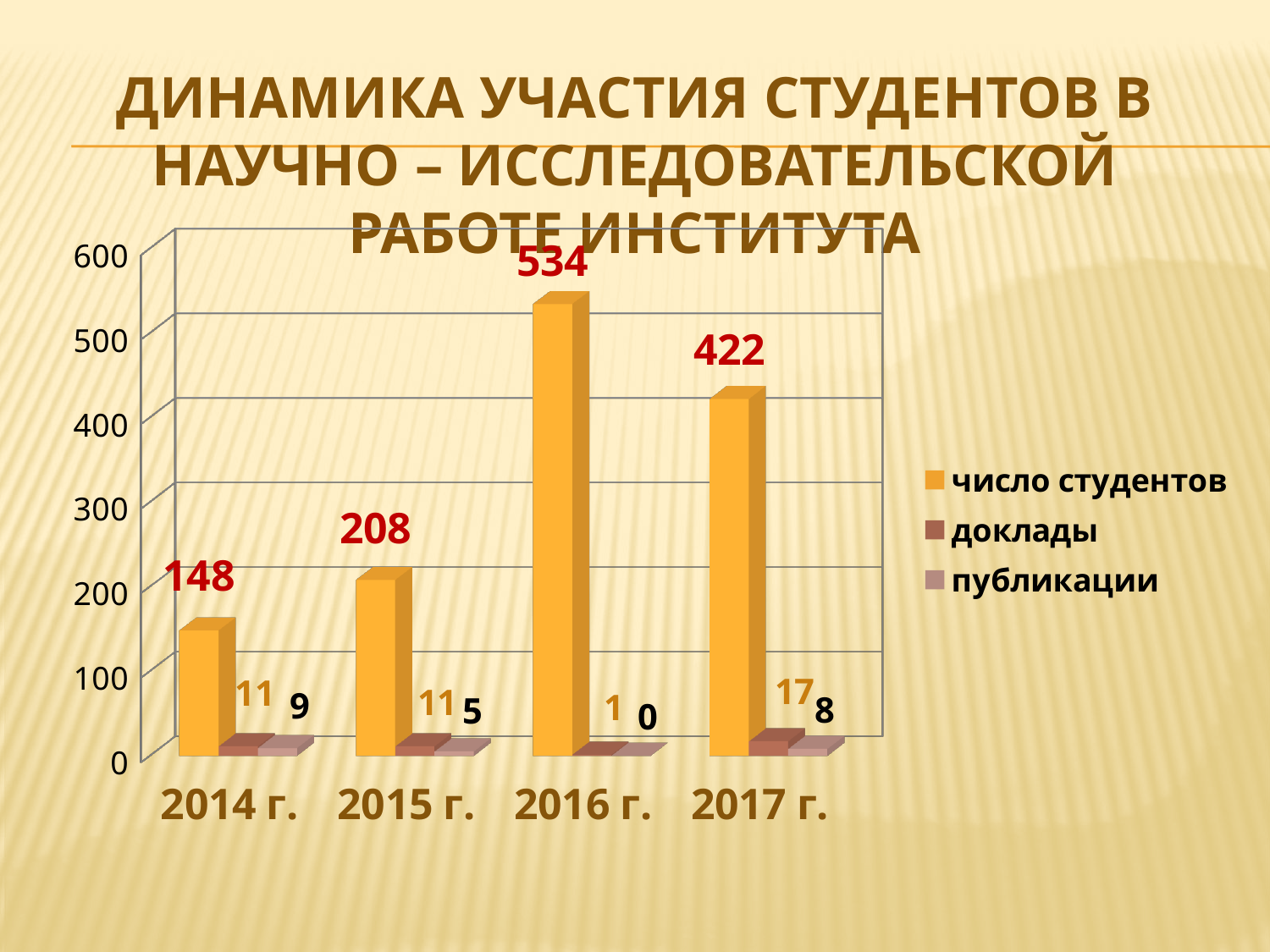
What is the value of "публикации" for 2016 г.? 0 What kind of chart is shown on the slide? bar chart What is the difference between "число студентов" in 2016 г. and 2017 г.? 112 How many series does the legend list? 3 Which year has the lowest value for "число студентов"? 2014 г. Is the value for "число студентов" in 2017 г. greater or less than 400? greater What is the value of "доклады" for 2017 г.? 17 What is the value of "публикации" for 2014 г.? 9 How many years are shown on the x axis? 4 What is the value of "число студентов" for 2016 г.? 534 Which year has the highest value for "число студентов"? 2016 г. Which is larger: "доклады" in 2017 г. or "доклады" in 2015 г.? 2017 г.